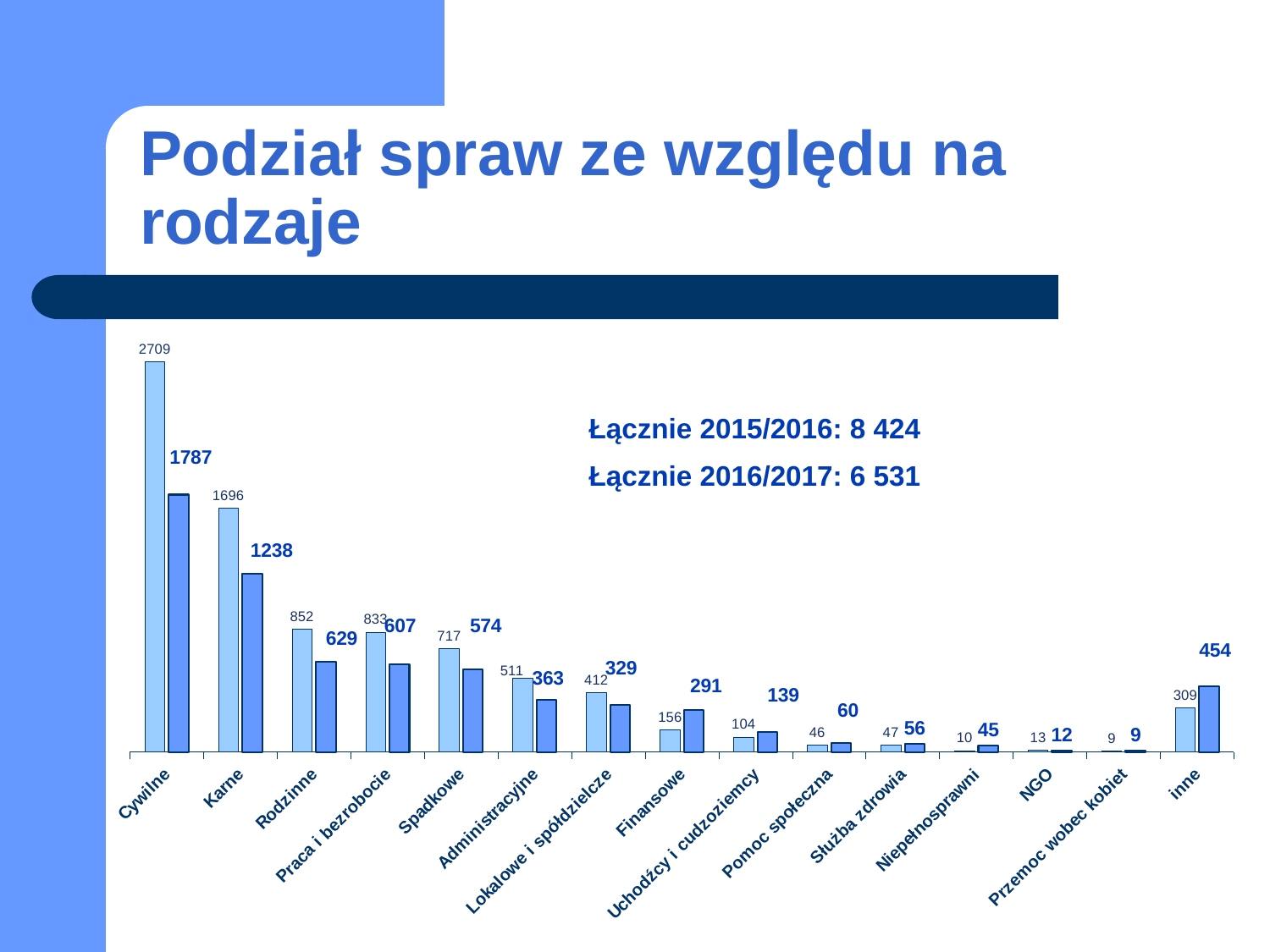
What type of chart is shown on the slide? bar chart What is the difference between the light blue and dark blue bars for Cywilne? 922 What is the value of the dark blue bar for inne? 454 For Finansowe, which bar is larger, the light blue or the dark blue? dark blue What is the value of the light blue bar for Cywilne? 2709 What is the value of the dark blue bar for Karne? 1238 Which category has the lowest light blue bar? Przemoc wobec kobiet What total is given on the slide for 2016/2017? 6 531 How many categories are shown on the x axis of the chart? 15 Which category has the highest light blue bar? Cywilne What is the value of the light blue bar for Administracyjne? 511 What is the difference between the light blue bars for Rodzinne and Praca i bezrobocie? 19